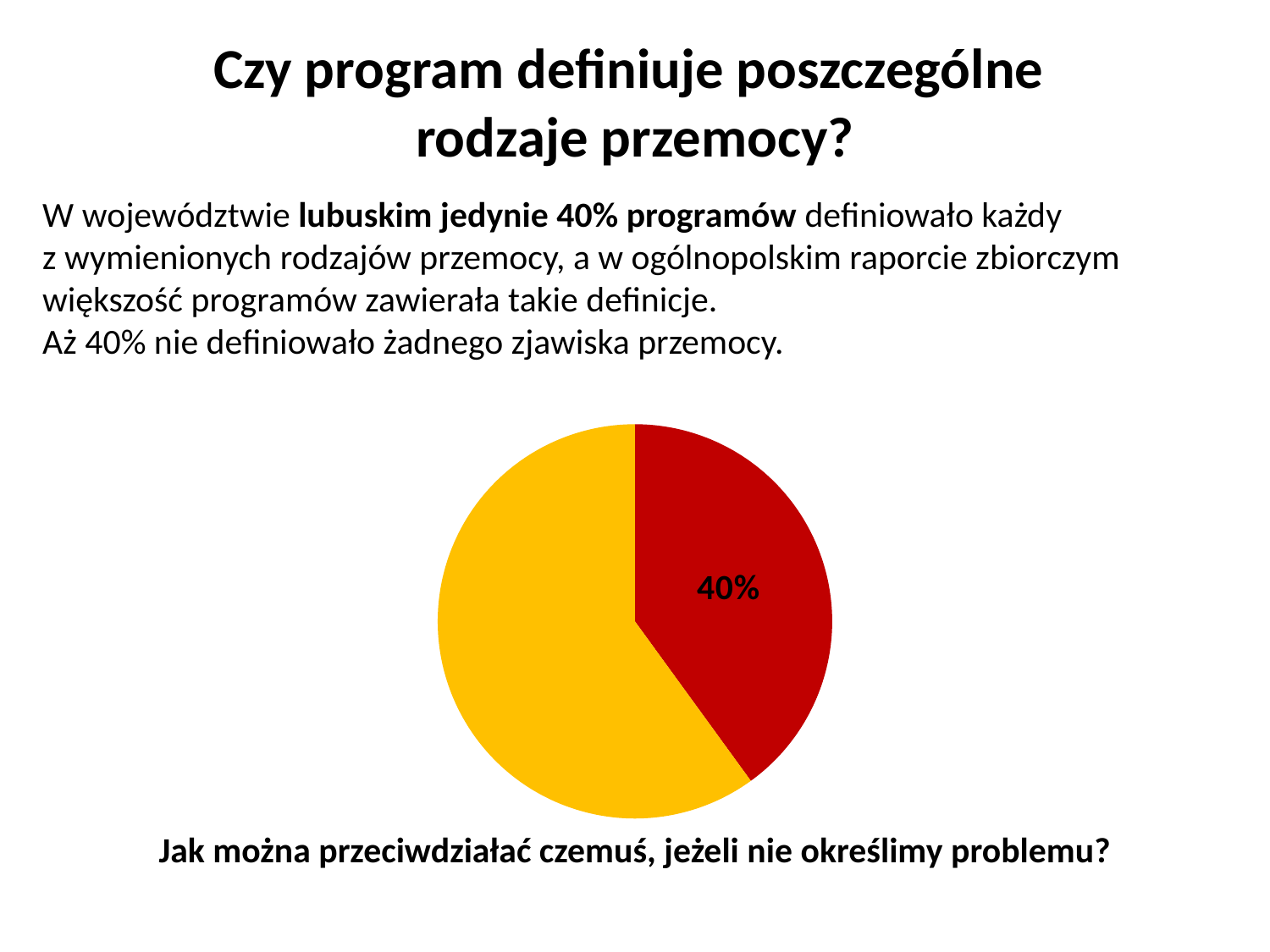
Which colour slice is the largest in the pie chart? yellow What value is printed on the red slice of the pie chart? 40% What share of the pie does the red slice represent? 40% How many slices does the pie chart have? 2 Which two colours are used for the slices of the pie chart? red and yellow Which colour slice is the smallest in the pie chart? red What kind of chart is shown on the slide? pie chart Which slice of the pie chart is larger, the red one or the yellow one? yellow How many slices of the pie chart have a printed data label? 1 Does the pie chart have a legend? no